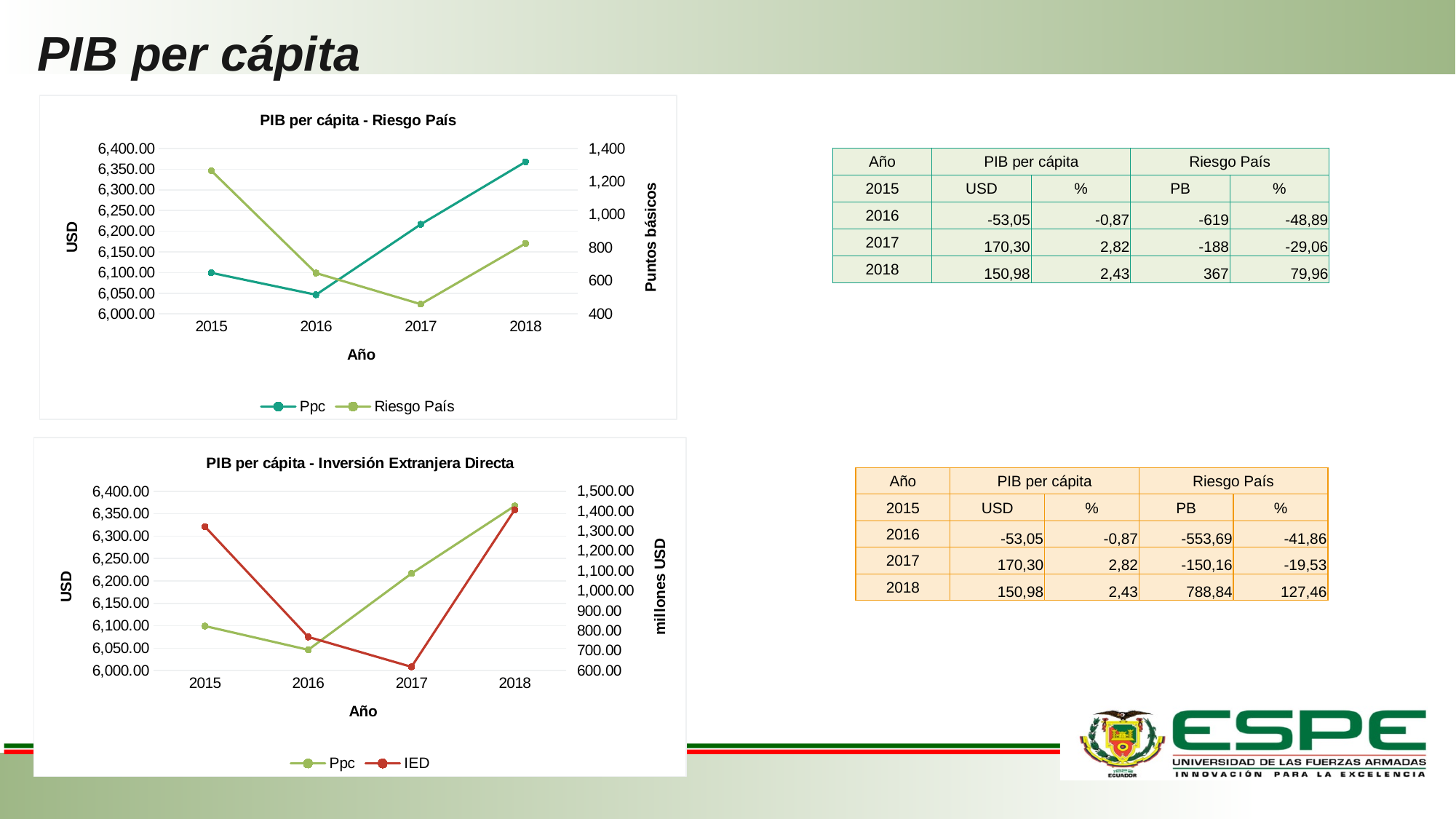
How many years are plotted on the x axis of the 'PIB per cápita - Inversión Extranjera Directa' chart? 4 In the 'PIB per cápita - Riesgo País' chart, in which year is the Ppc series highest? 2018 In the 'PIB per cápita - Inversión Extranjera Directa' chart, is the IED value for 2017 greater or less than 700.00? less In the 'PIB per cápita - Riesgo País' chart, does the Ppc series rise or fall from 2016 to 2018? rise In the 'PIB per cápita - Riesgo País' chart, in which year is the Ppc series lowest? 2016 What kind of chart is the 'PIB per cápita - Riesgo País' chart? line chart In the 'PIB per cápita - Riesgo País' chart, is the Riesgo País value for 2015 greater or less than 1,200? greater In the 'PIB per cápita - Inversión Extranjera Directa' chart, in which year is the IED series highest? 2018 How many series does the legend of the 'PIB per cápita - Riesgo País' chart list? 2 What is the label of the right-hand vertical axis in the 'PIB per cápita - Inversión Extranjera Directa' chart? millones USD In the 'PIB per cápita - Riesgo País' chart, is the Ppc value for 2016 greater or less than 6,100.00? less In the 'PIB per cápita - Riesgo País' chart, in which year is the Riesgo País series lowest? 2017